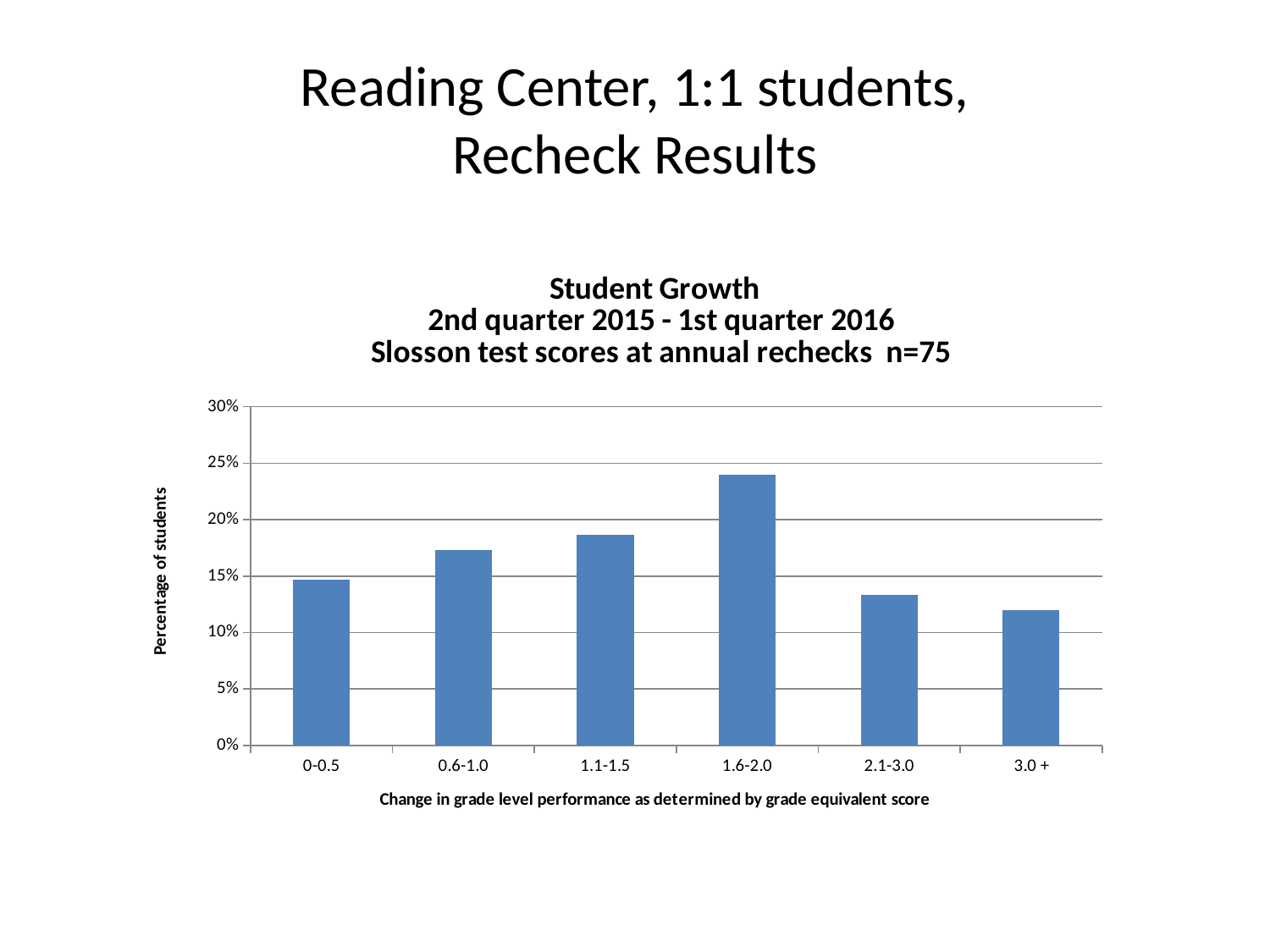
Which is larger, the value for 0.6-1.0 or the value for 2.1-3.0? 0.6-1.0 Which category has the lowest percentage of students? 3.0 + What kind of chart is shown on the slide? bar chart Is the value for 3.0 + greater or less than 10%? greater Is the value for 1.6-2.0 greater or less than 20%? greater How many categories are shown on the x axis of the chart? 6 Which is larger, the value for 1.6-2.0 or the value for 3.0 +? 1.6-2.0 What sample size (n) is stated in the chart title? n=75 Which category has the highest percentage of students? 1.6-2.0 Is the value for 1.1-1.5 greater or less than 20%? less What is the label of the y axis of the chart? Percentage of students